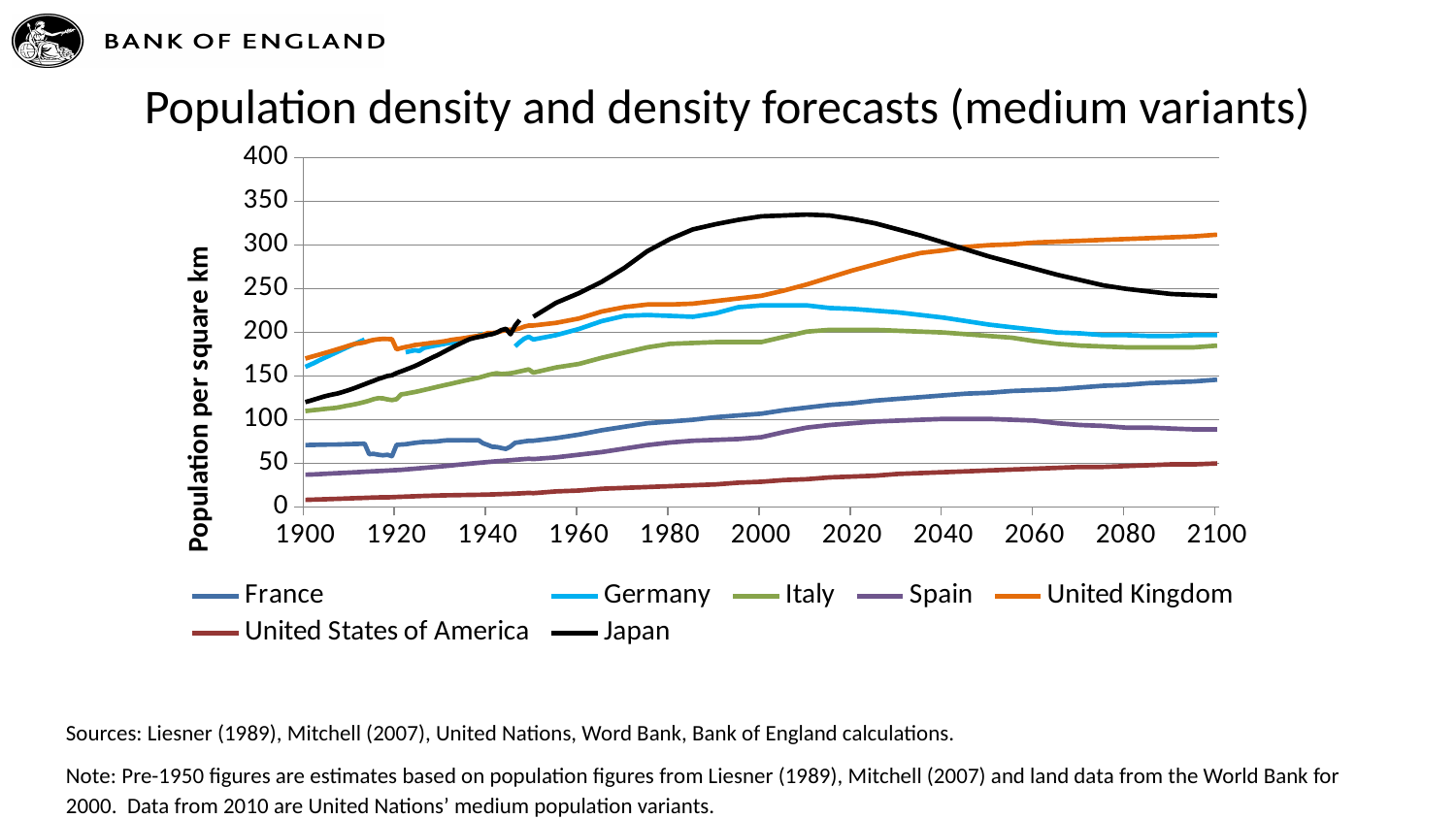
Is the value for United States of America in 2100 greater or less than 100? less Is the value for Japan in 2000 greater or less than 300? greater In 2100, which is larger: the value for France or the value for Spain? France Does the value for Japan rise or fall between 2020 and 2100? Fall What is the label on the vertical axis? Population per square km Which series has the highest value in 2000? Japan What kind of chart is shown on the slide? Line chart Which series has the lowest values across the whole period? United States of America What is the title of the chart? Population density and density forecasts (medium variants) Is the value for Spain in 1900 greater or less than 50? less How many series does the legend list? 7 Which series has the highest value in 2100? United Kingdom